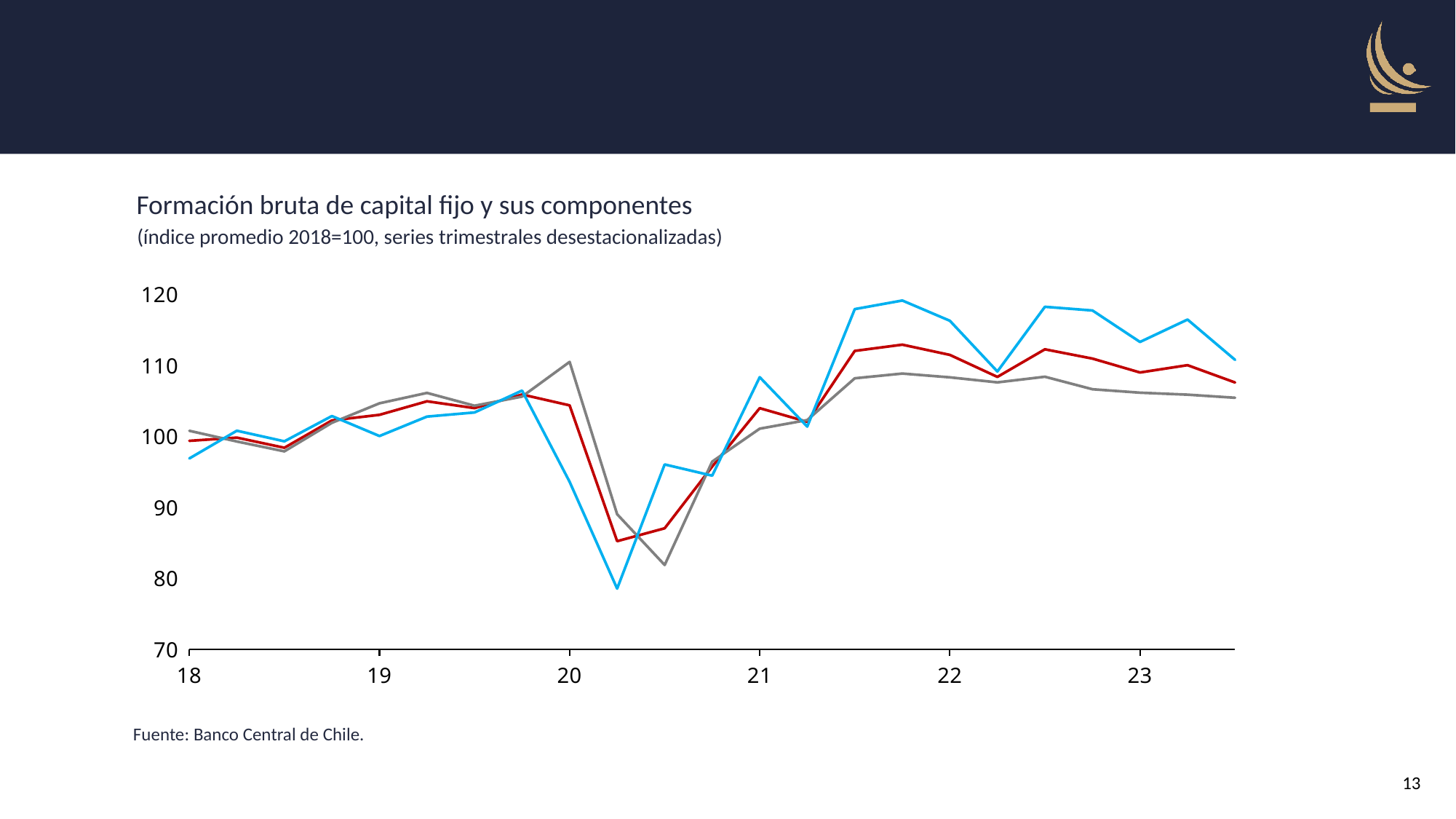
Which line reaches the highest point on the chart? the blue line Is the lowest value of the gray line greater or less than 90? less At the x-axis label 22, which line is higher, the blue line or the gray line? the blue line How many lines are plotted on the chart? 3 How many year labels are shown on the x axis? 6 What source is cited below the chart? Banco Central de Chile What is the title of the chart? Formación bruta de capital fijo y sus componentes Is the highest value of the blue line greater or less than 110? greater What kind of chart is shown on the slide? line chart Is the lowest value of the blue line greater or less than 80? less Which line reaches the lowest point on the chart? the blue line Does the blue line rise or fall between the x-axis labels 20 and the low point just after it? fall